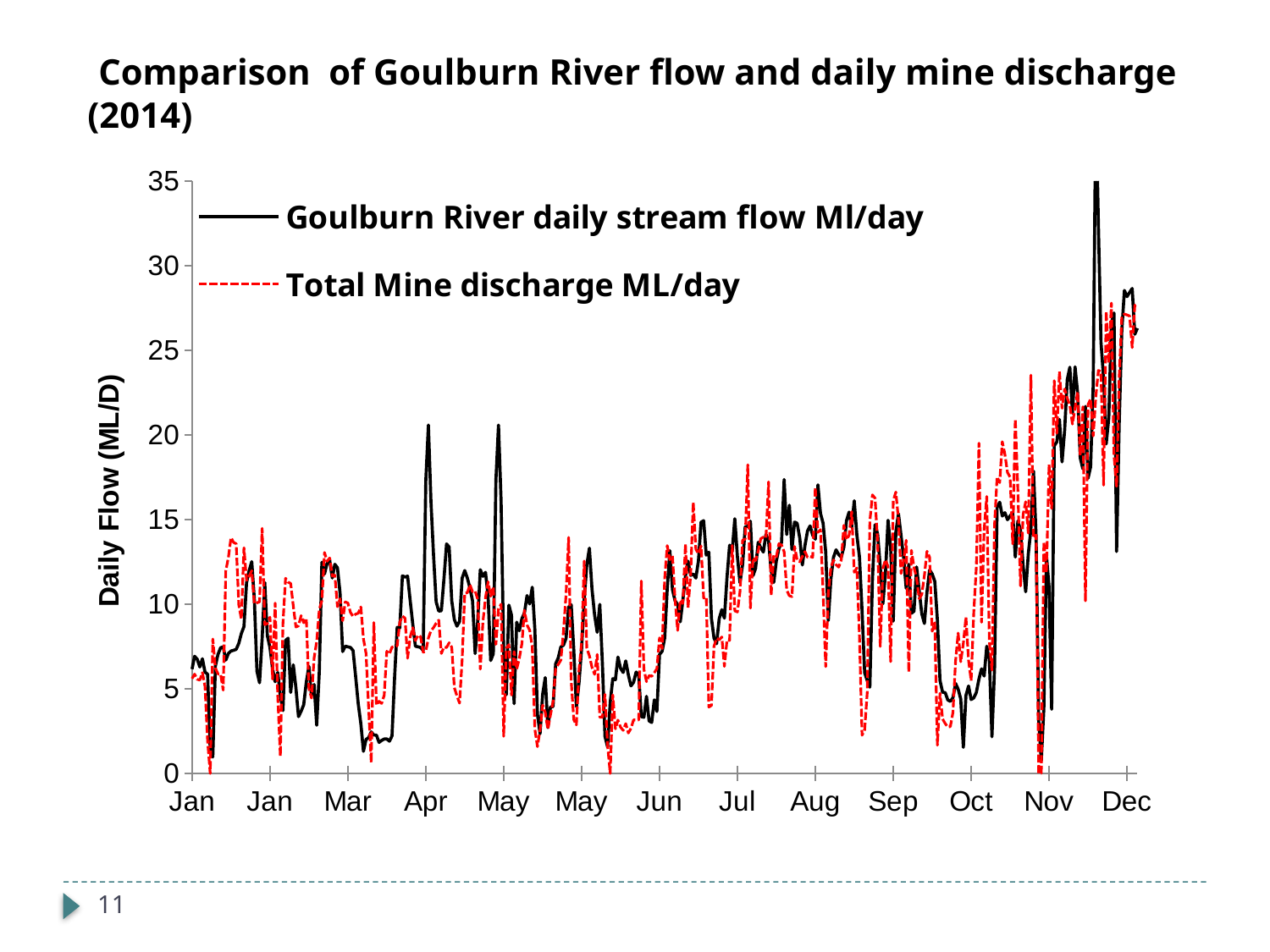
Which series is drawn as a red dashed line? Total Mine discharge ML/day Overall, do the values of both series rise or fall from Jan to Dec? rise Is the highest peak of the Goulburn River daily stream flow greater or less than 30? greater What kind of chart is shown on the slide? Line chart Is the Goulburn River daily stream flow at the Dec label greater or less than 20? greater Is the lowest value of the Total Mine discharge around the second May label greater or less than 5? less What is the title of the chart? Comparison of Goulburn River flow and daily mine discharge (2014) At the sharp spike near the Apr label, which series is higher: Goulburn River daily stream flow or Total Mine discharge? Goulburn River daily stream flow Ml/day How many series does the legend list? 2 Which series reaches the highest value anywhere on the chart? Goulburn River daily stream flow Ml/day What is the label on the vertical axis? Daily Flow (ML/D)